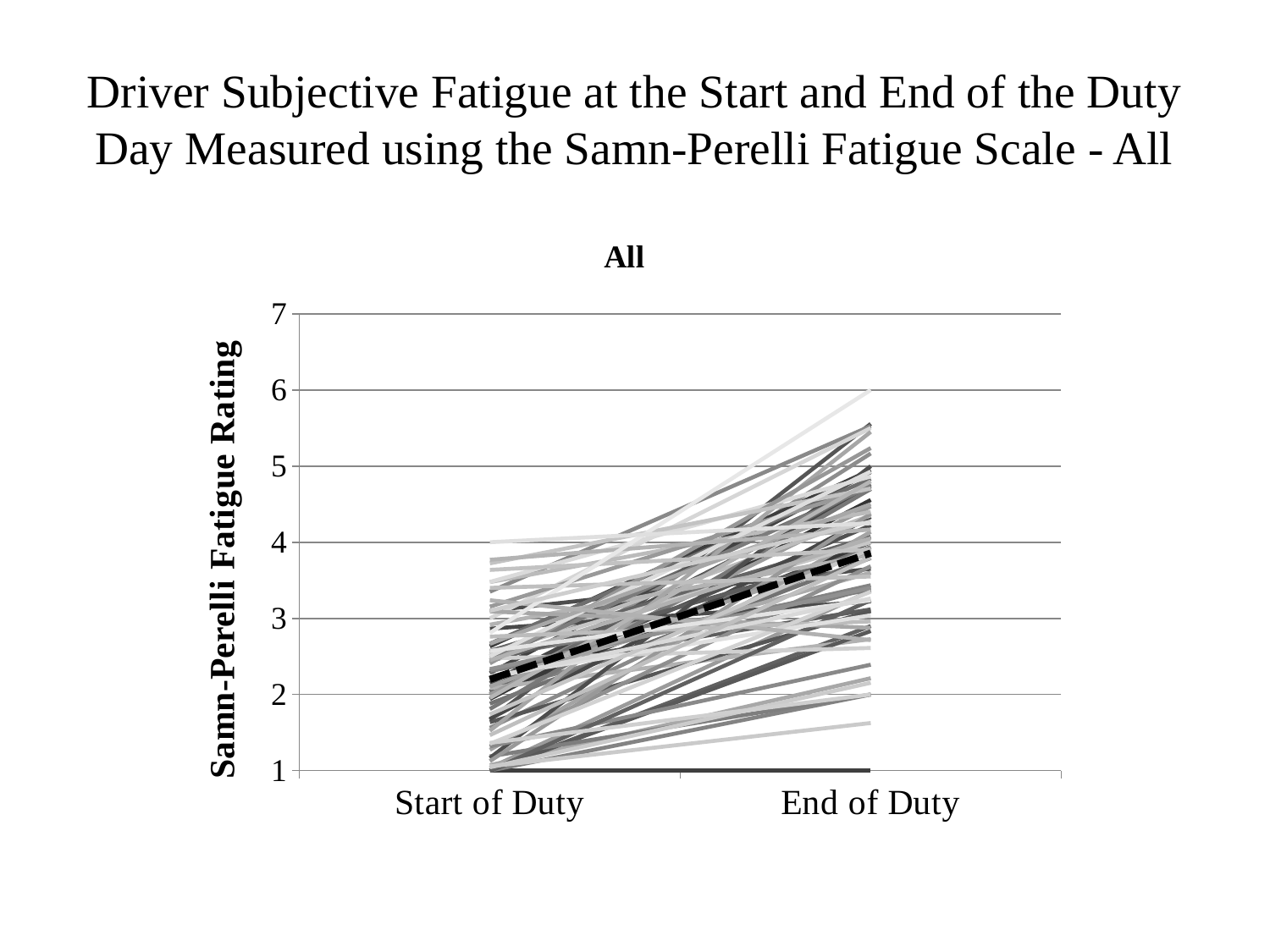
What is the title printed above the plot area of the chart? All What is the highest tick value shown on the y axis of the chart? 7 What is the label of the y axis of the chart? Samn-Perelli Fatigue Rating Is the dashed black line higher at Start of Duty or at End of Duty? End of Duty Do the lines in the chart generally rise or fall from Start of Duty to End of Duty? rise How many categories are shown on the x axis of the chart? 2 What kind of chart is shown on the slide? line chart Is the value of the dashed black line at End of Duty greater or less than 4? less Is the value of the dashed black line at Start of Duty greater or less than 2? greater Is the value of the dashed black line at End of Duty greater or less than 3? greater